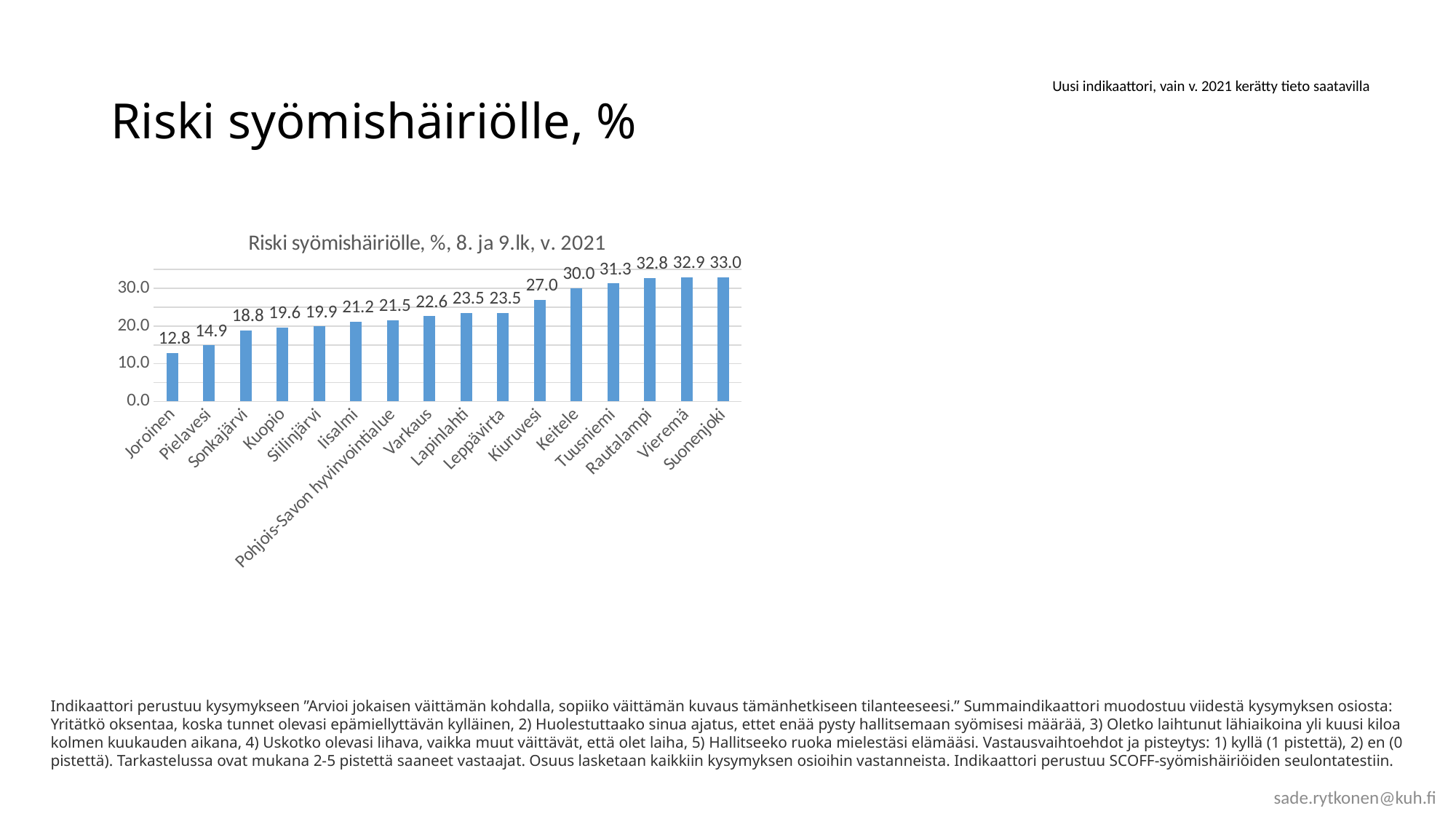
What is the value for Pohjois-Savon hyvinvointialue? 21.5 Which category has the lowest value? Joroinen What is the value for Tuusniemi? 31.3 Which is larger, the value for Varkaus or the value for Iisalmi? Varkaus What is the value for Kuopio? 19.6 What kind of chart is shown on the slide? bar chart Do the values rise or fall from left to right along the x axis? rise Is the value for Pielavesi greater or less than 20.0? less What is the difference between the values for Kuopio and Joroinen? 6.8 Is the value for Rautalampi greater or less than 30.0? greater What is the difference between the values for Keitele and Kiuruvesi? 3.0 How many categories are shown on the x axis? 16